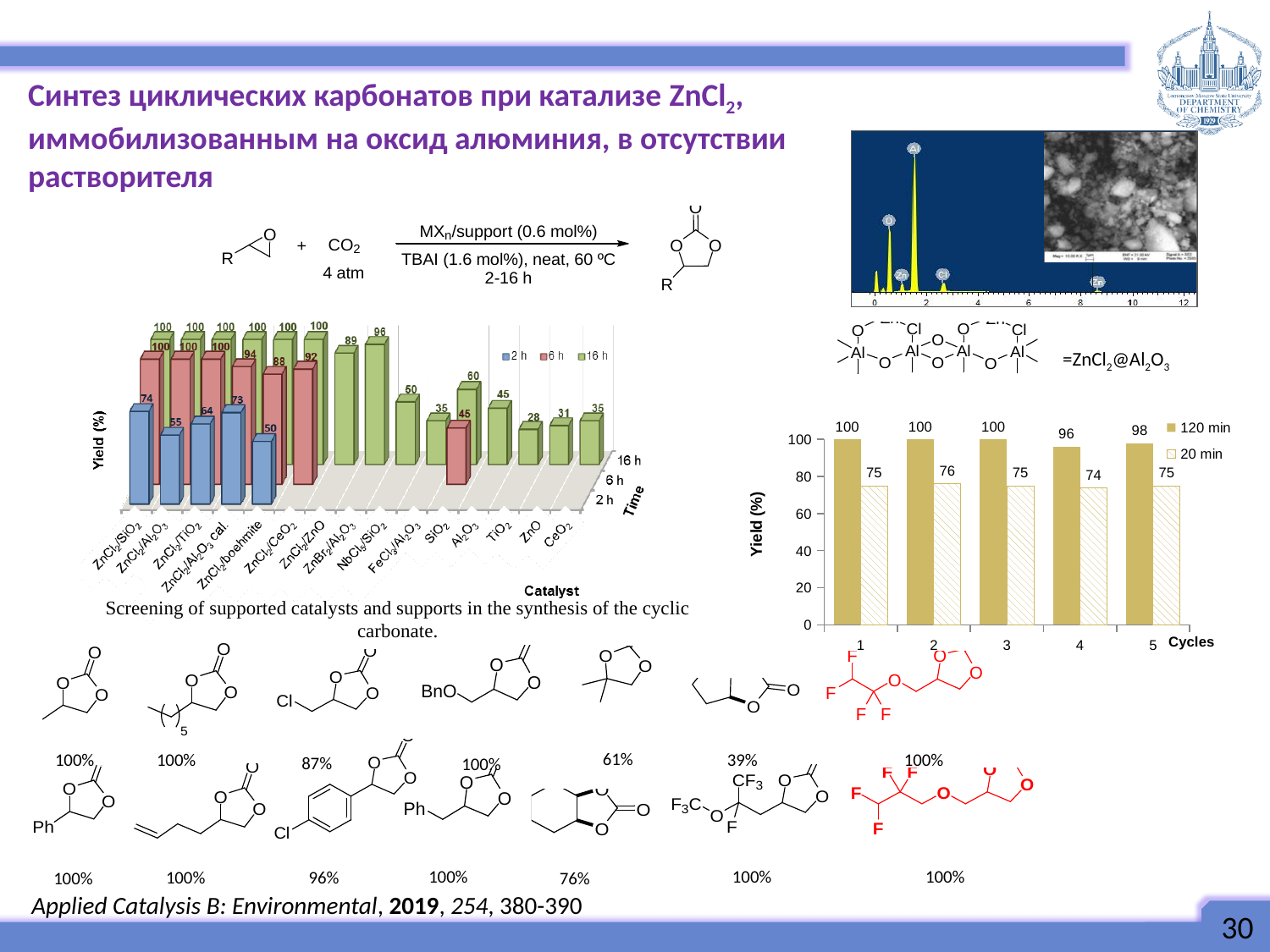
In the right-hand chart (Cycles), which cycle has the lowest 20 min yield? 4 In the right-hand chart (Cycles), how many cycles are plotted on the x axis? 5 In the left-hand chart (Screening of supported catalysts), what is the 16 h yield for ZnBr2/Al2O3? 96 What kind of chart is the left-hand chart (Screening of supported catalysts)? bar chart In the right-hand chart (Cycles), what is the label of the y axis? Yield (%) In the left-hand chart (Screening of supported catalysts), which is larger: the 16 h yield for ZnCl2/ZnO or for TiO2? ZnCl2/ZnO In the right-hand chart (Cycles), what is the yield for 120 min at cycle 4? 96 In the right-hand chart (Cycles), what is the yield for 120 min at cycle 5? 98 In the left-hand chart (Screening of supported catalysts), what is the 2 h yield for ZnCl2/SiO2? 74 In the right-hand chart (Cycles), what is the yield for 20 min at cycle 2? 76 In the right-hand chart (Cycles), how many series does the legend list? 2 In the right-hand chart (Cycles), what is the difference between the 120 min and 20 min yields at cycle 1? 25